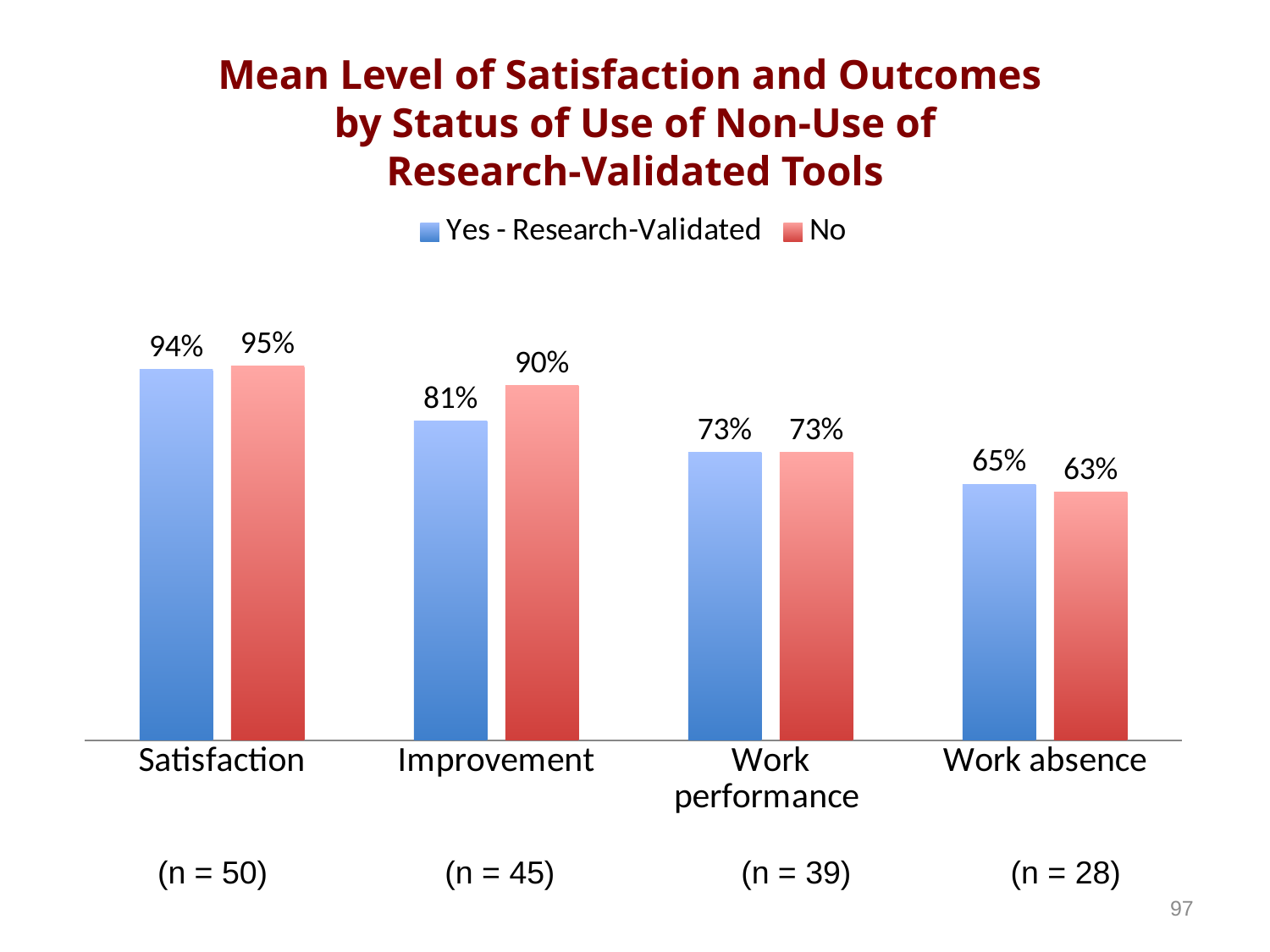
What is the value for Satisfaction in the Yes - Research-Validated series? 94% How many series does the legend list? 2 Which category has the lowest value in the Yes - Research-Validated series? Work absence What is the value for Improvement in the No series? 90% How many categories are shown on the x axis? 4 What is the value for Work performance in the No series? 73% What is the difference between the No and Yes - Research-Validated values for Improvement? 9% Which category has the highest value in the No series? Satisfaction What is the value for Work absence in the Yes - Research-Validated series? 65% What is the sample size (n) shown for the Work performance category? n = 39 What kind of chart is shown on the slide? Bar chart For Work absence, which series has the larger value, Yes - Research-Validated or No? Yes - Research-Validated